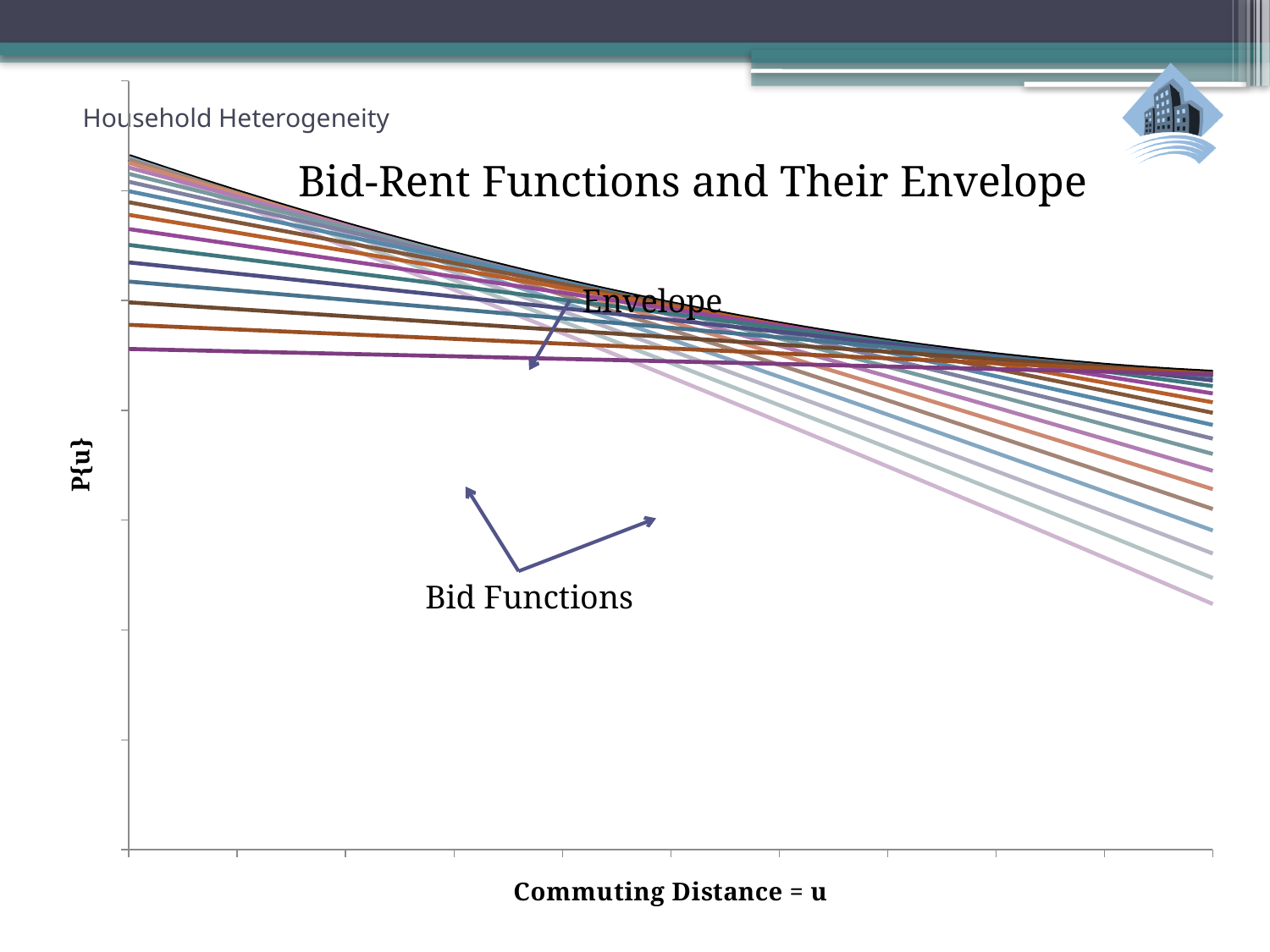
What is the title of the chart? Bid-Rent Functions and Their Envelope Does the envelope curve rise or fall as you move from left to right along the x axis? fall What is the label on the x axis of the chart? Commuting Distance = u What kind of chart is shown on the slide? line chart Do the bid functions rise or fall as commuting distance u increases along the x axis? fall